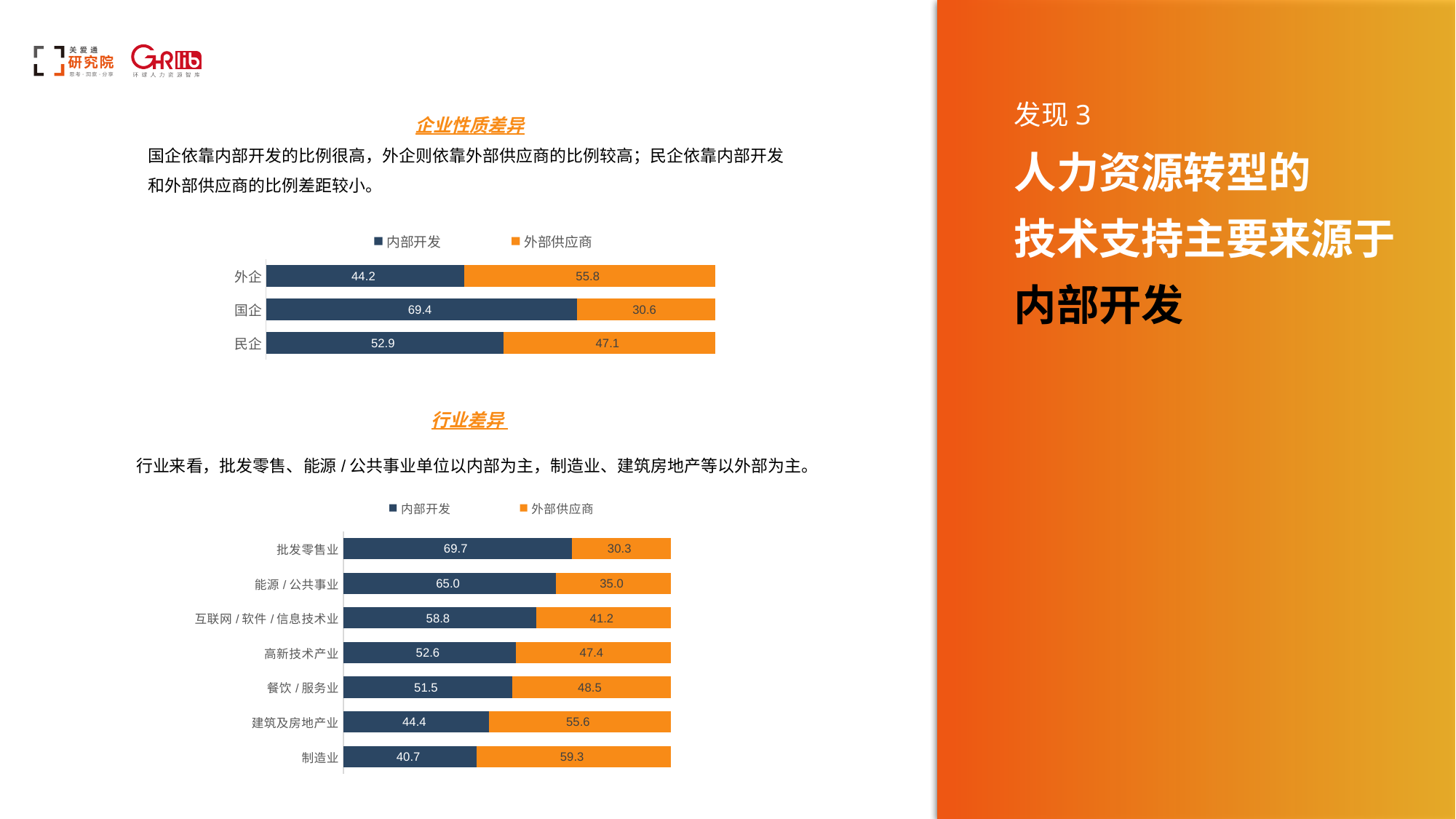
In the 行业差异 chart, what is the 内部开发 value for 互联网 / 软件 / 信息技术业? 58.8 In the 企业性质差异 chart, what is the difference between the 内部开发 and 外部供应商 values for 民企? 5.8 In the 企业性质差异 chart, what is the 内部开发 value for 国企? 69.4 In the 企业性质差异 chart, which category has the highest 内部开发 value? 国企 In the 行业差异 chart, which industry has the lowest 内部开发 value? 制造业 In the 企业性质差异 chart, what is the 外部供应商 value for 外企? 55.8 In the 行业差异 chart, is the 内部开发 value larger for 高新技术产业 or 建筑及房地产业? 高新技术产业 In the 行业差异 chart, how many industries are shown? 7 In the 行业差异 chart, which industry has the highest 内部开发 value? 批发零售业 In the 行业差异 chart, what is the 外部供应商 value for 制造业? 59.3 In the 企业性质差异 chart, how many categories are shown? 3 What type of chart is the 行业差异 chart? Stacked bar chart